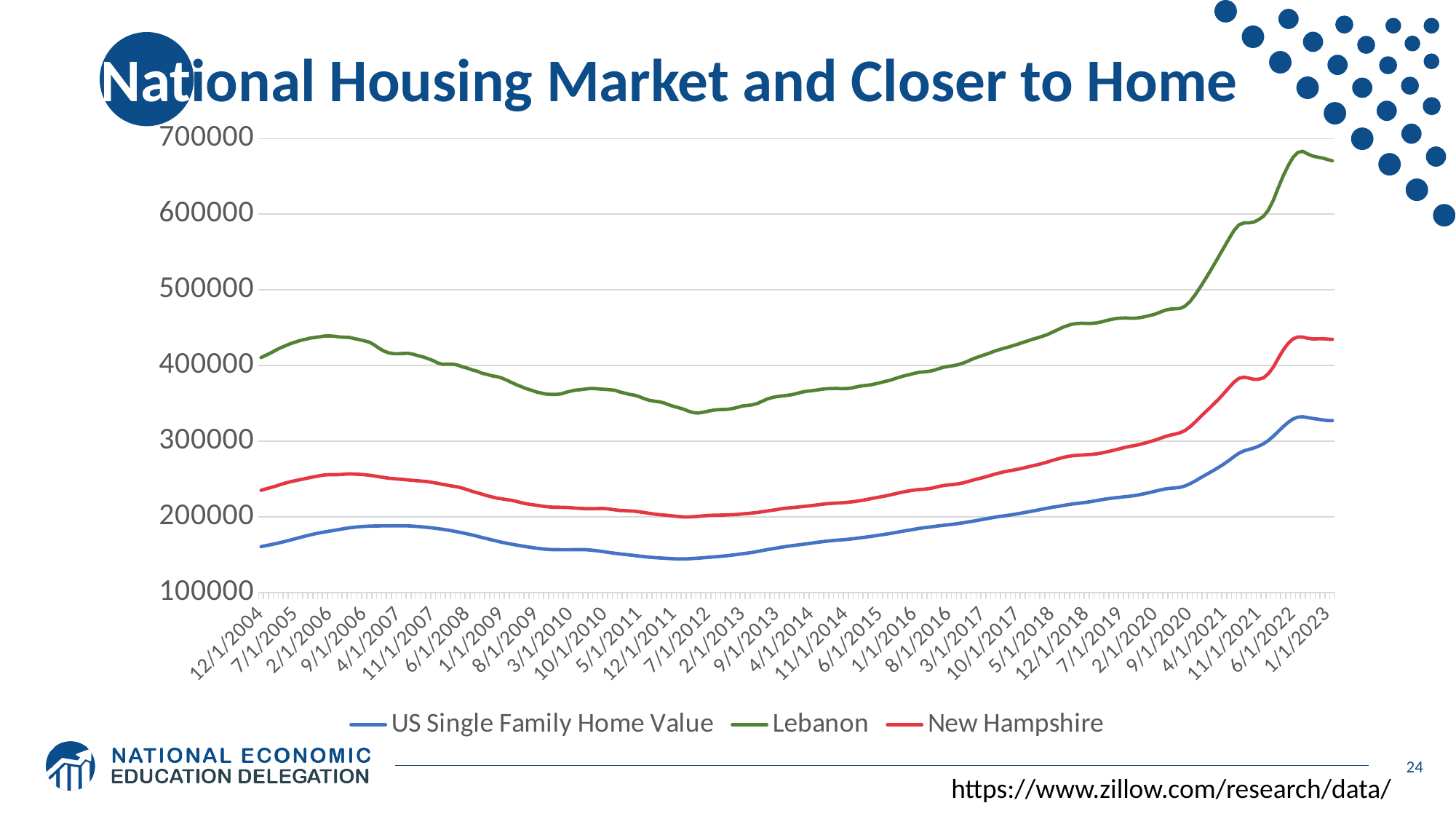
What kind of chart is shown on the slide? Line chart Does the Lebanon line rise or fall between 9/1/2020 and 6/1/2022? Rises What is the title of the chart on the slide? National Housing Market and Closer to Home Is the value for Lebanon at 7/1/2012 greater or less than 400000? less At 1/1/2023, which is larger: Lebanon or New Hampshire? Lebanon Which colour is used for the Lebanon line? Green Is the value for Lebanon at 1/1/2023 greater or less than 600000? greater Is the value for New Hampshire at 12/1/2004 greater or less than 300000? less How many series does the legend list? 3 Which series has the lowest values across the whole chart? US Single Family Home Value Which series has the highest values across the whole chart? Lebanon